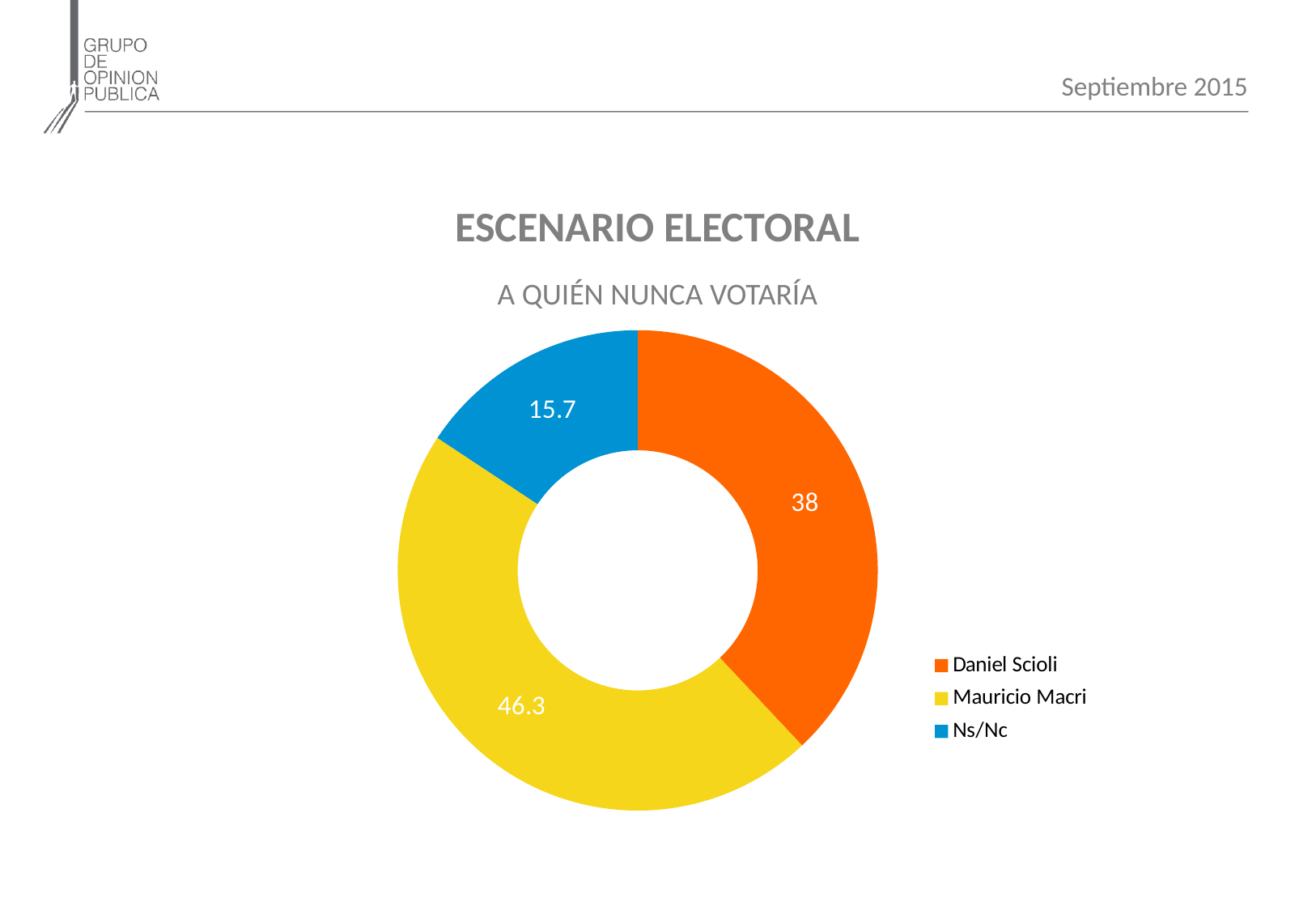
What is the difference between the values for Daniel Scioli and Ns/Nc? 22.3 What is the difference between the values for Mauricio Macri and Daniel Scioli? 8.3 What is the subtitle of the chart? A QUIÉN NUNCA VOTARÍA Which category has the largest slice? Mauricio Macri What kind of chart is shown on the slide? Doughnut (pie) chart Which is larger, the value for Daniel Scioli or the value for Ns/Nc? Daniel Scioli How many categories does the chart show? 3 What value is shown for Daniel Scioli? 38 Which colour represents Ns/Nc in the legend? Blue What value is shown for Mauricio Macri? 46.3 What value is shown for Ns/Nc? 15.7 Which category has the smallest slice? Ns/Nc